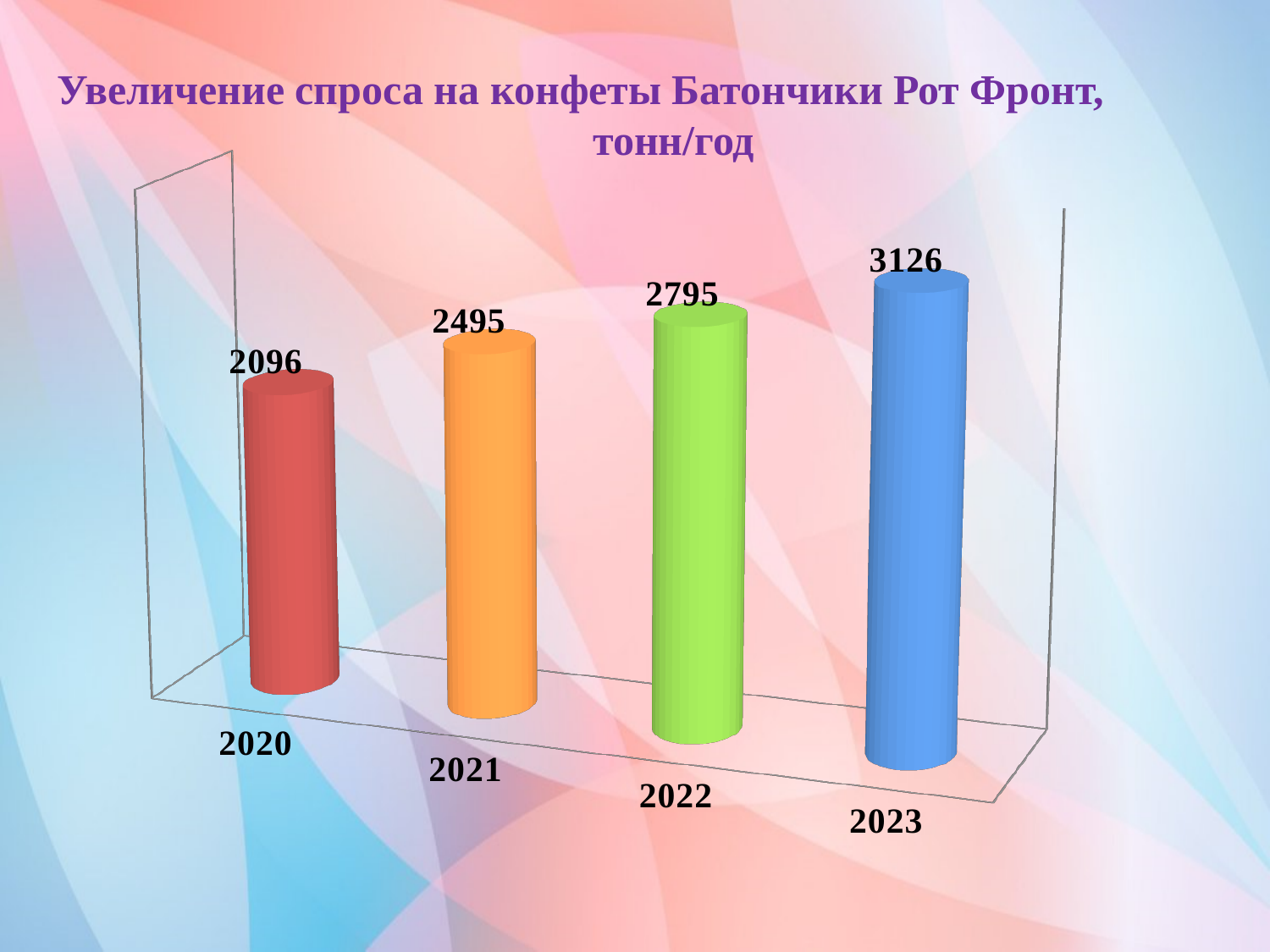
What is the value for 2022? 2795 What kind of chart is shown on the slide? Bar chart What is the value for 2020? 2096 What is the value for 2021? 2495 Which is larger, the value for 2021 or the value for 2022? 2022 Which year has the lowest value? 2020 What is the value for 2023? 3126 How many years are shown on the chart? 4 What is the difference between the values for 2023 and 2020? 1030 Which year has the highest value? 2023 Do the values rise or fall from 2020 to 2023? Rise What is the difference between the values for 2022 and 2021? 300